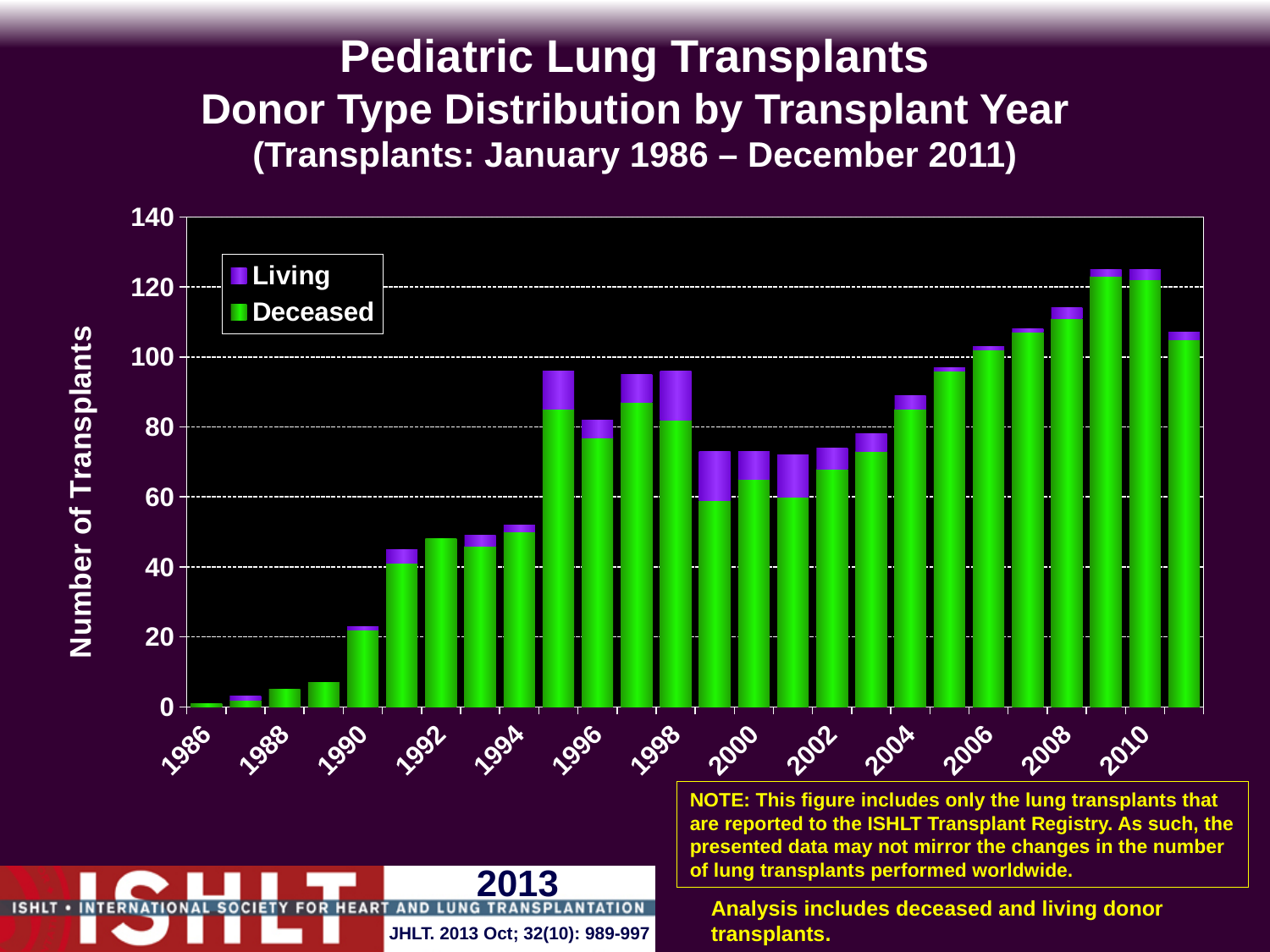
Is the total number of transplants in 1989 greater or less than 20? less What are the two series named in the legend? Living and Deceased What is the label of the y axis? Number of Transplants Which year has the lowest total number of transplants? 1986 Do the total numbers of transplants generally rise or fall from 2001 to 2009? rise Which year has the larger total number of transplants, 1996 or 1990? 1996 What kind of chart is shown on the slide? stacked bar chart Is the total number of transplants in 1999 greater or less than 80? less How many series does the legend list? 2 Is the total number of transplants in 1995 greater or less than 80? greater How many transplant years (bars) are plotted on the chart? 26